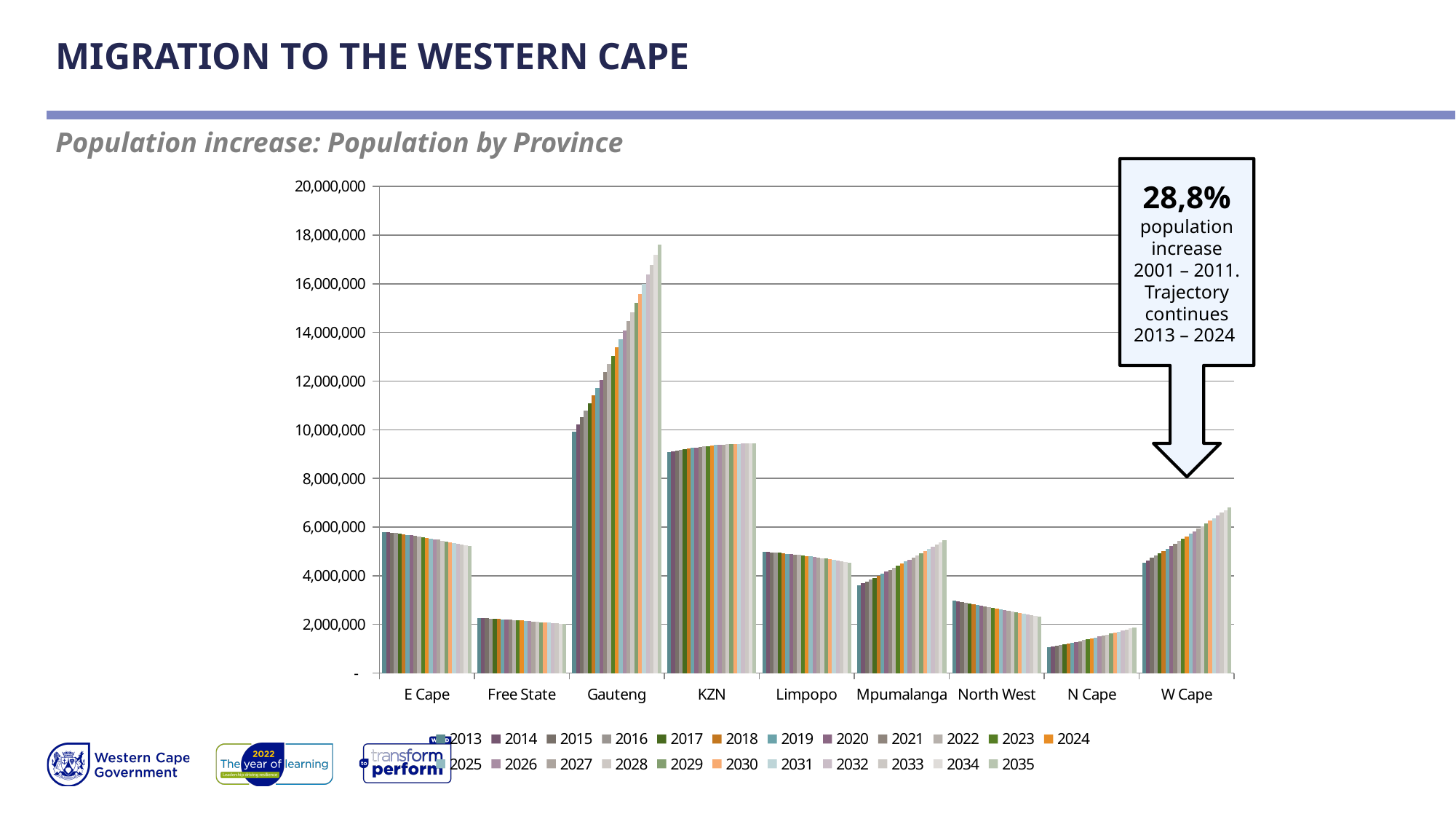
Is the value for Gauteng in 2035 greater or less than 16,000,000? greater How many series (years) does the chart legend list? 23 Which province has the larger population in 2013, KZN or E Cape? KZN What kind of chart is shown on the slide? Bar chart Is the value for Free State in 2013 greater or less than 4,000,000? less Is the value for W Cape in 2035 greater or less than 6,000,000? greater Which province has the lowest population values in the chart? N Cape Which province has the highest population values in the chart? Gauteng Do the W Cape bars rise or fall from 2013 to 2035? Rise How many provinces are shown on the x axis of the chart? 9 What percentage population increase for 2001 – 2011 is stated in the callout box on the slide? 28,8%